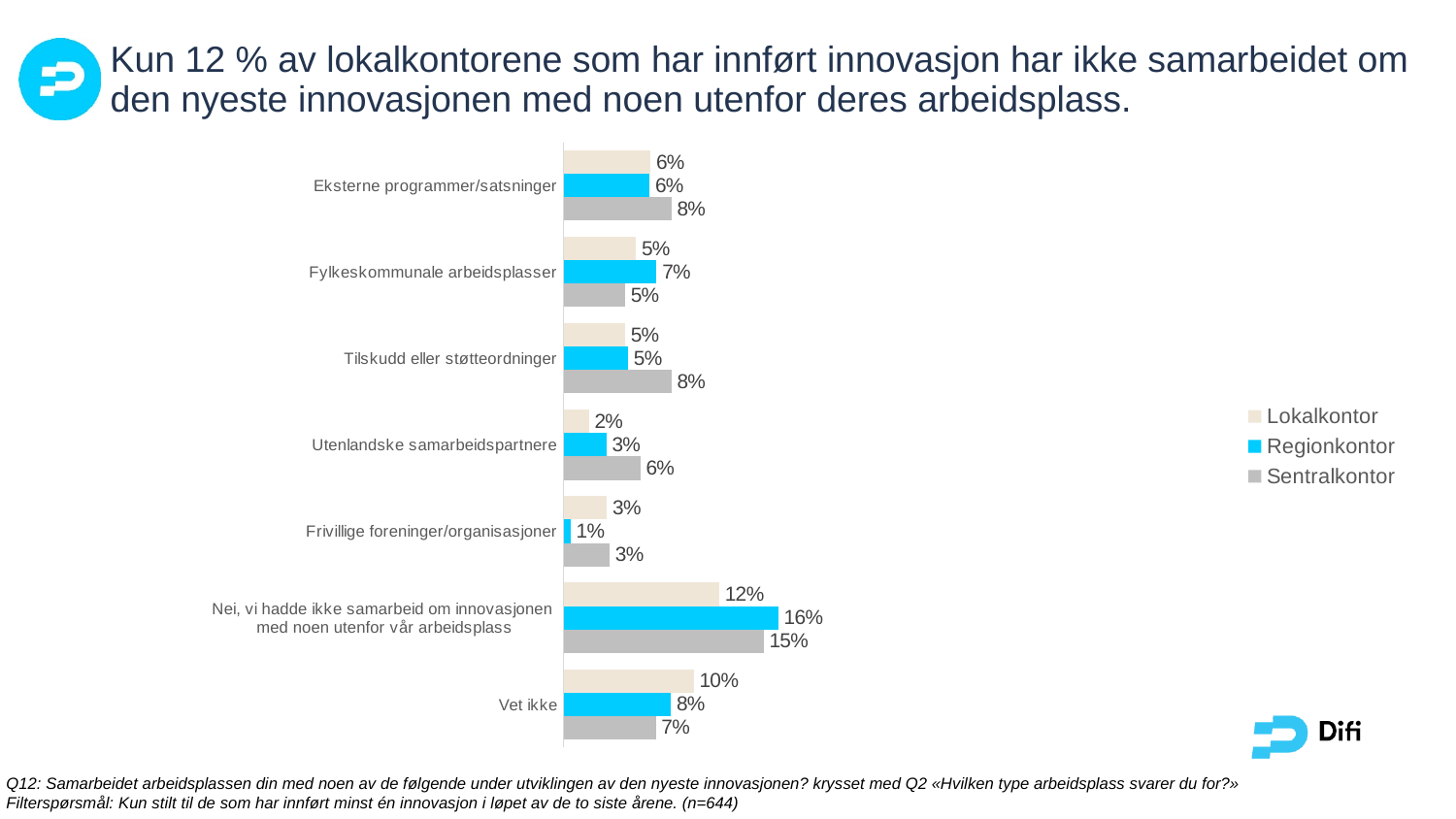
How many series does the legend list? 3 How many categories are shown on the chart? 7 What is the difference between the Regionkontor and Lokalkontor values for "Nei, vi hadde ikke samarbeid om innovasjonen med noen utenfor vår arbeidsplass"? 4 percentage points What is the Lokalkontor value for "Vet ikke"? 10% What is the Sentralkontor value for "Utenlandske samarbeidspartnere"? 6% Which series is shown in blue in the legend? Regionkontor Which category has the lowest Regionkontor value? Frivillige foreninger/organisasjoner Which category has the highest Lokalkontor value? Nei, vi hadde ikke samarbeid om innovasjonen med noen utenfor vår arbeidsplass What kind of chart is shown on the slide? Bar chart What is the Regionkontor value for "Nei, vi hadde ikke samarbeid om innovasjonen med noen utenfor vår arbeidsplass"? 16% For "Vet ikke", which is larger: the Lokalkontor value or the Sentralkontor value? Lokalkontor What is the Regionkontor value for "Frivillige foreninger/organisasjoner"? 1%